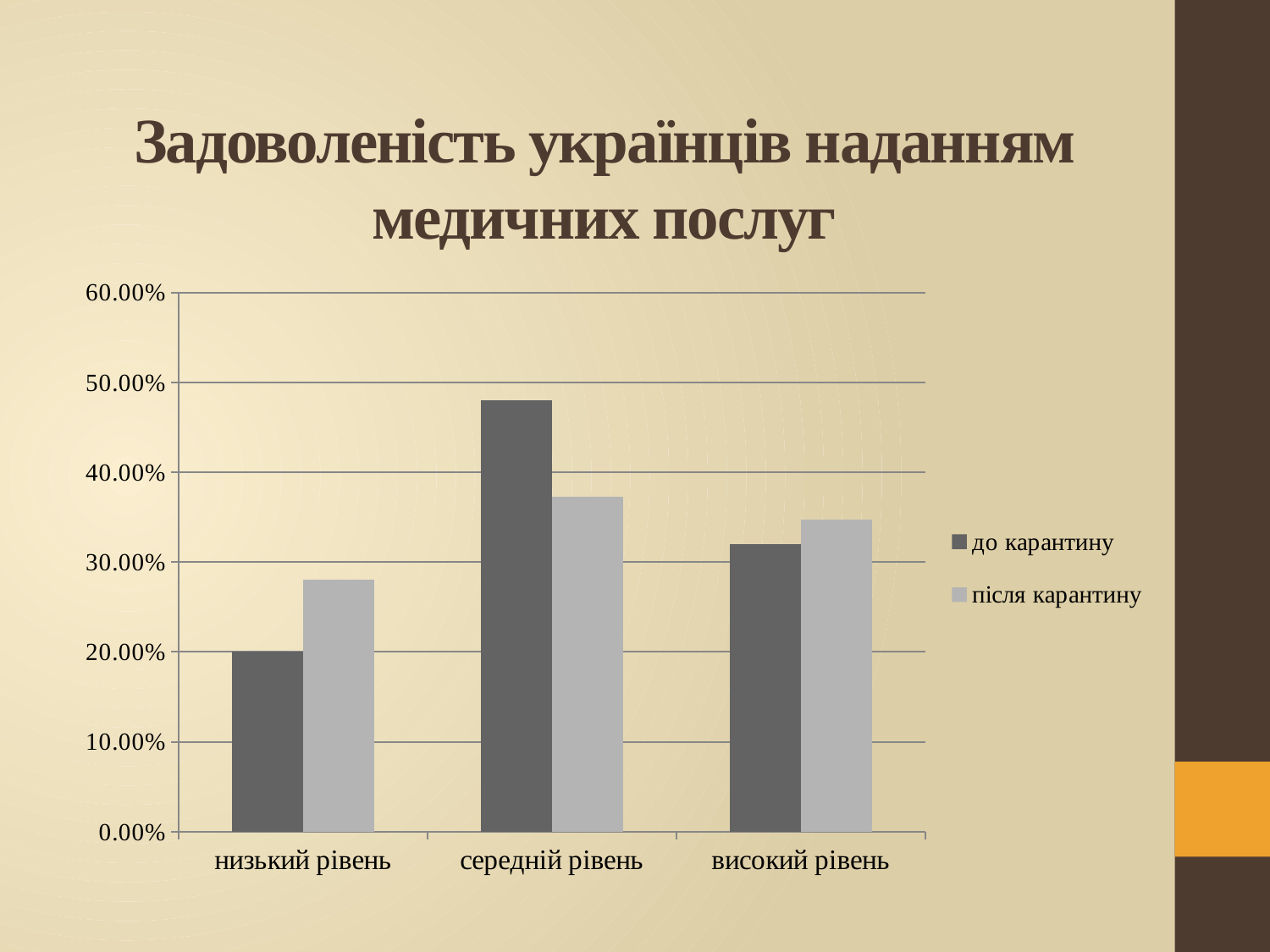
For 'середній рівень', which series has the larger value: 'до карантину' or 'після карантину'? до карантину What kind of chart is shown on the slide? bar chart What are the two series named in the legend? до карантину, після карантину How many categories are shown on the x axis of the chart? 3 Which category has the highest bar for the series 'до карантину'? середній рівень Which category has the lowest bar for the series 'після карантину'? низький рівень For 'низький рівень', which series has the larger value: 'до карантину' or 'після карантину'? після карантину Which category has the highest bar for the series 'після карантину'? середній рівень How many series does the legend list? 2 What is the title of the chart on the slide? Задоволеність українців наданням медичних послуг Is the value for 'середній рівень' in the series 'до карантину' greater or less than 40.00%? greater Which category has the lowest bar for the series 'до карантину'? низький рівень